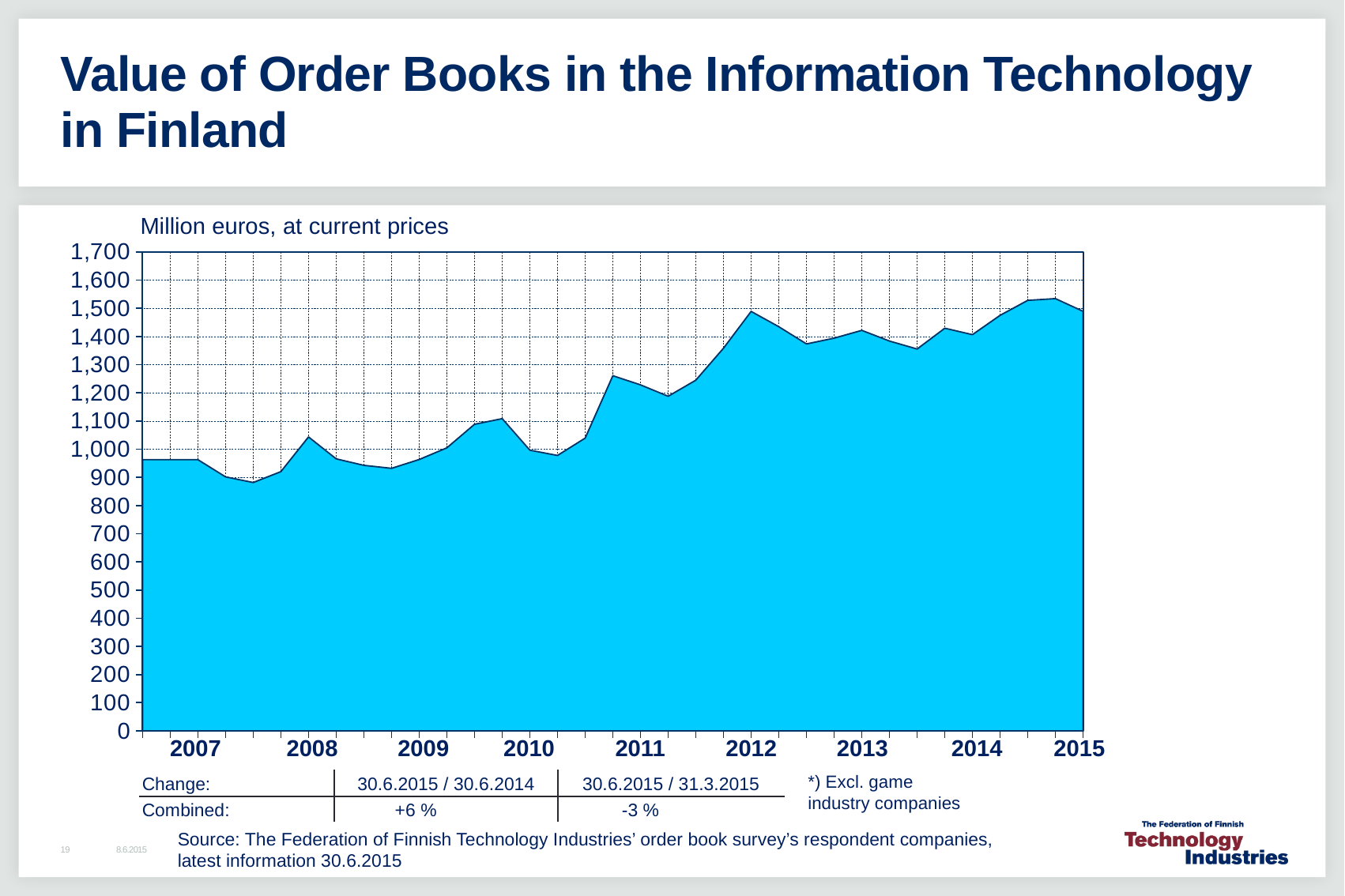
According to the table below the chart, what is the combined change for 30.6.2015 / 30.6.2014? +6 % Is the value of order books at the start of 2007 greater or less than 900? greater What unit is the y axis of the chart measured in? Million euros, at current prices What kind of chart is shown on the slide? Area chart Overall, do the values rise or fall from 2007 to 2015? rise Is the value of order books at the start of 2011 greater or less than 1,100? greater Is the value of order books at the end of the series in 2015 greater or less than 1,400? greater Do the values rise or fall between the start of 2010 and the start of 2012? rise How many years are labelled on the x axis of the chart? 9